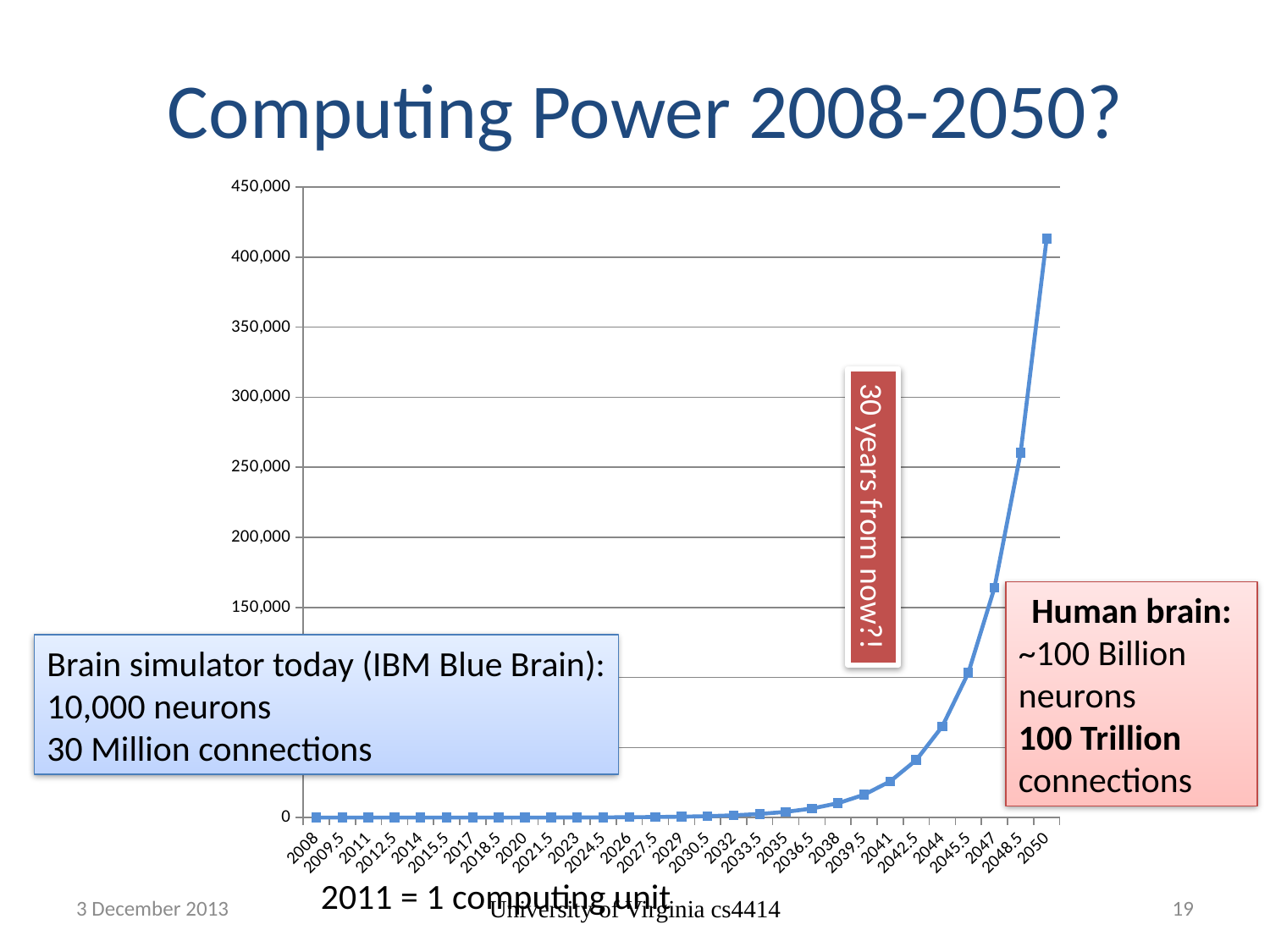
What is the highest value shown on the y axis? 450,000 How many year labels are shown along the x axis? 29 Is the value for 2048.5 greater or less than 300,000? less Which is larger, the value for 2050 or the value for 2047? 2050 Is the value for 2008 greater or less than 50,000? less What kind of chart is shown on the slide? line chart Is the value for 2047 greater or less than 150,000? greater Which year has the highest value on the chart? 2050 What is the title of the chart? Computing Power 2008-2050? Do the values rise or fall as the years move from 2008 to 2050? rise